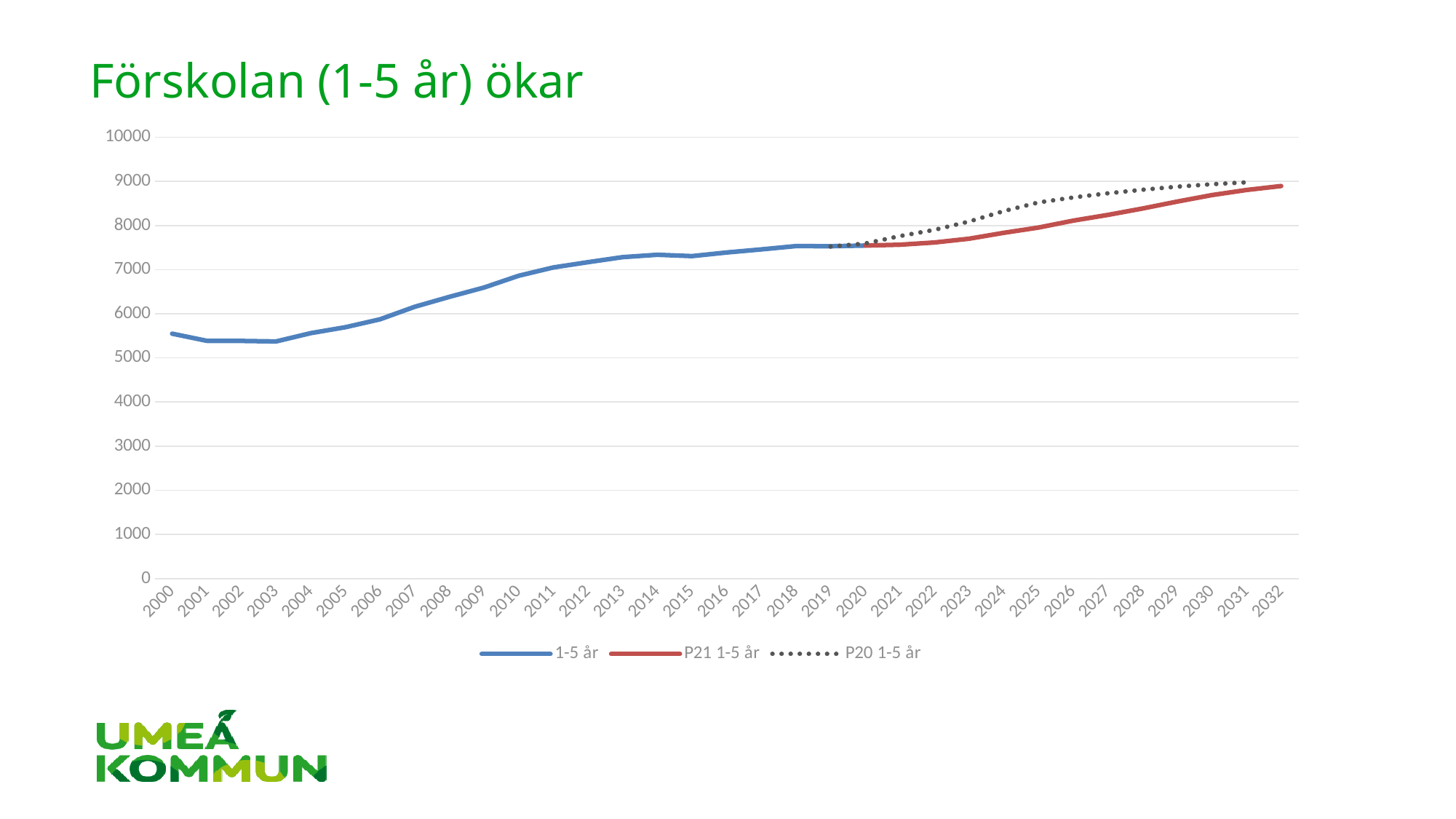
Which series is drawn as a dotted line? P20 1-5 år Is the value for P21 1-5 år in 2032 greater or less than 9000? less Is the value for 1-5 år in 2000 greater or less than 6000? less Is the value for 1-5 år in 2020 greater or less than 8000? less What is the title of the chart? Förskolan (1-5 år) ökar In 2025, which series has the higher value, P20 1-5 år or P21 1-5 år? P20 1-5 år How many years are shown on the x axis? 33 What kind of chart is shown on the slide? line chart How many series does the legend list? 3